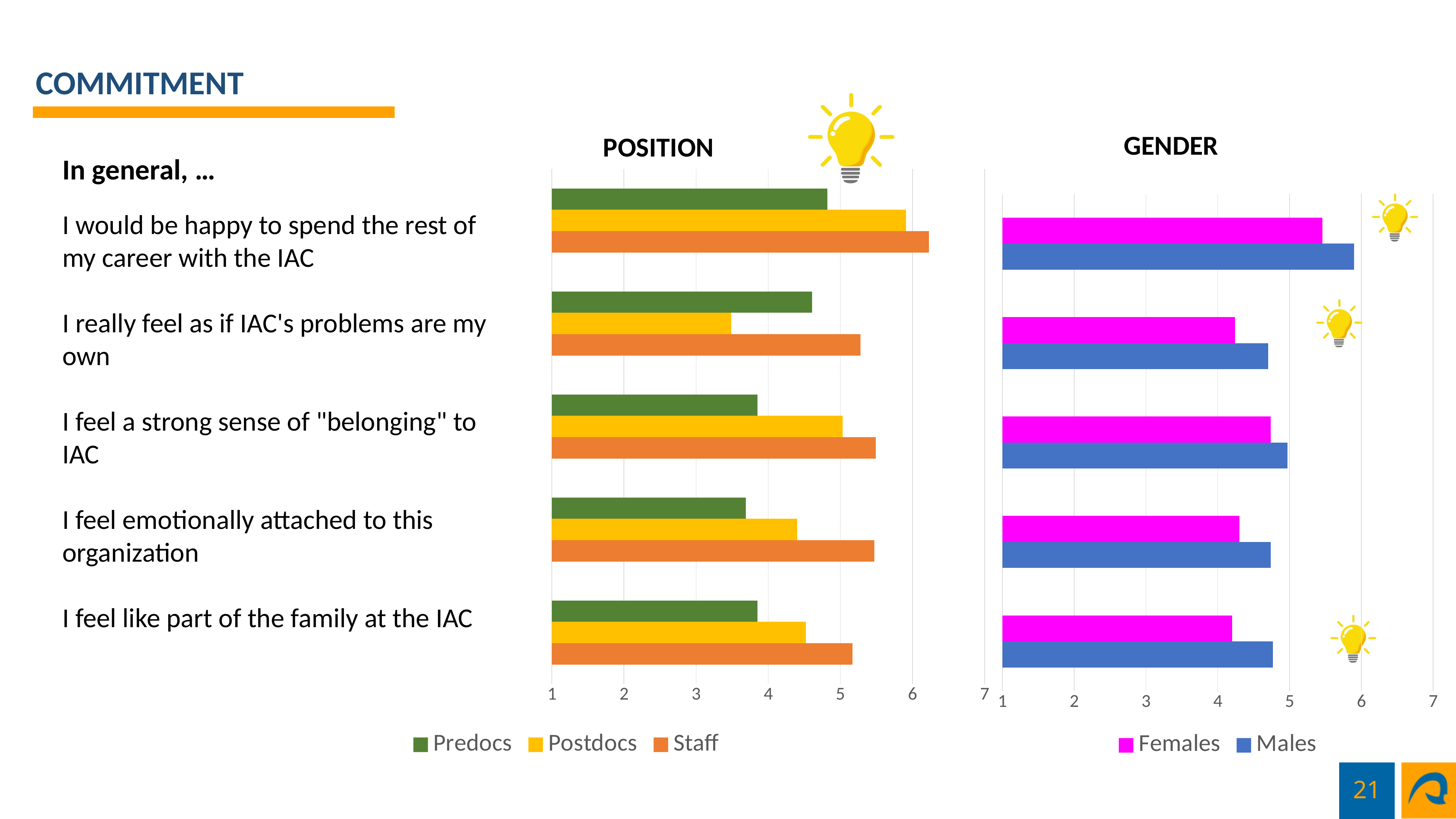
In the POSITION chart, for "I really feel as if IAC's problems are my own", which is larger: Predocs or Postdocs? Predocs How many statements (categories) are plotted in the GENDER chart? 5 In the POSITION chart, is the Postdocs value for "I really feel as if IAC's problems are my own" greater or less than 4? less In the POSITION chart, which series has the highest value for "I feel emotionally attached to this organization"? Staff In the GENDER chart, what colour are the Females bars? Magenta (pink) In the GENDER chart, is the Females value for "I feel like part of the family at the IAC" greater or less than 5? less How many series does the legend of the GENDER chart list? 2 In the POSITION chart, which series has the lowest value for "I feel like part of the family at the IAC"? Predocs In the GENDER chart, is the Males value for "I would be happy to spend the rest of my career with the IAC" greater or less than 5? greater How many series does the legend of the POSITION chart list? 3 What kind of chart is the POSITION chart? Bar chart In the GENDER chart, for "I would be happy to spend the rest of my career with the IAC", which is larger: Females or Males? Males